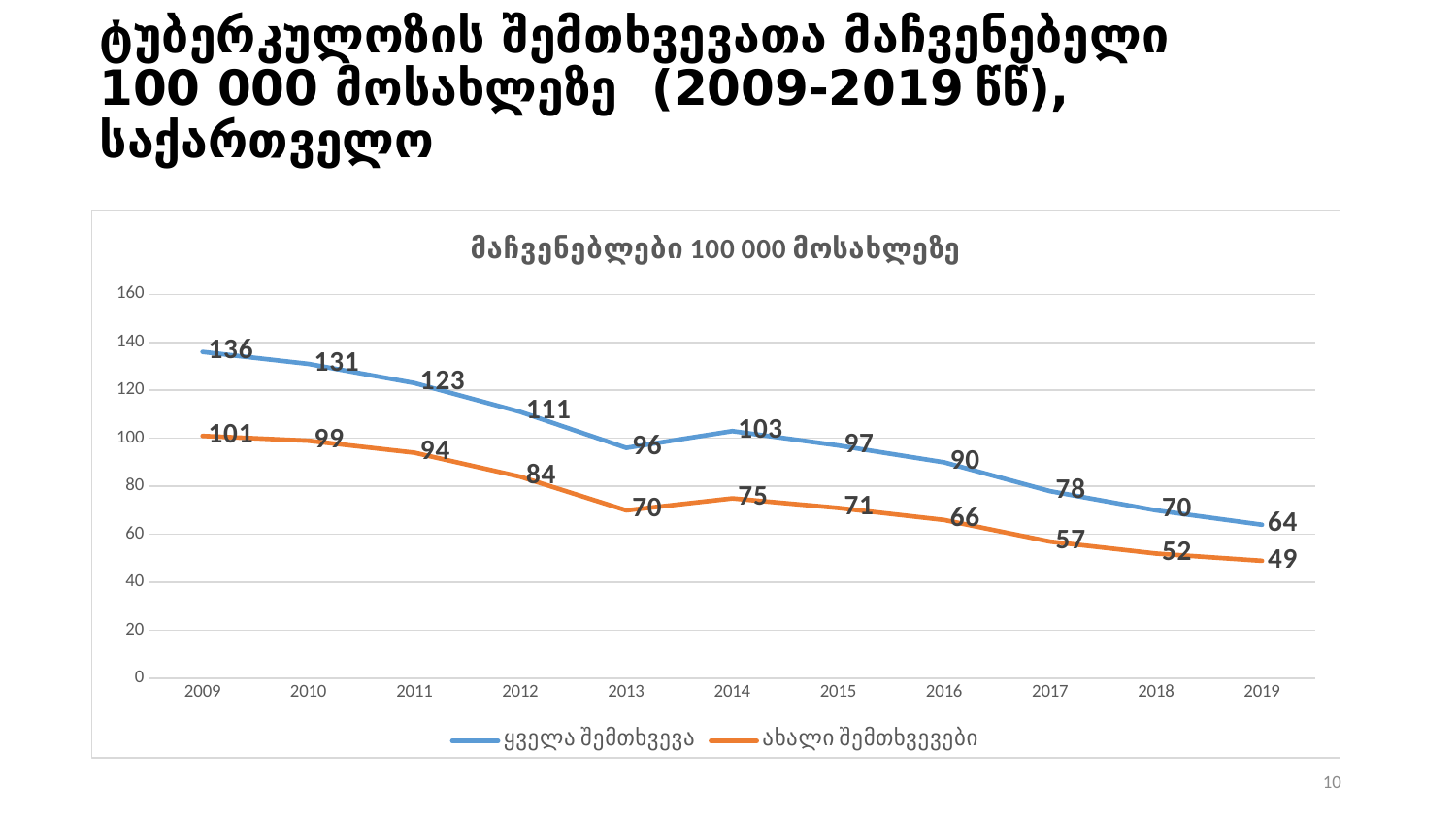
Does the "ყველა შემთხვევა" series generally rise or fall from 2009 to 2019? fall Which is larger: the "ყველა შემთხვევა" value in 2017 or the "ახალი შემთხვევები" value in 2012? ახალი შემთხვევები in 2012 What is the value of the "ახალი შემთხვევები" series in 2019? 49 How many series does the legend list? 2 What kind of chart is shown on the slide? line chart What is the value of the "ყველა შემთხვევა" series in 2009? 136 What is the value of the "ყველა შემთხვევა" series in 2014? 103 Is the value of the "ყველა შემთხვევა" series in 2012 greater or less than 100? greater How many years are shown on the x axis? 11 In which year is the "ახალი შემთხვევები" series at its lowest? 2019 What is the difference between the "ყველა შემთხვევა" and "ახალი შემთხვევები" values in 2013? 26 In which year is the "ყველა შემთხვევა" series at its highest? 2009